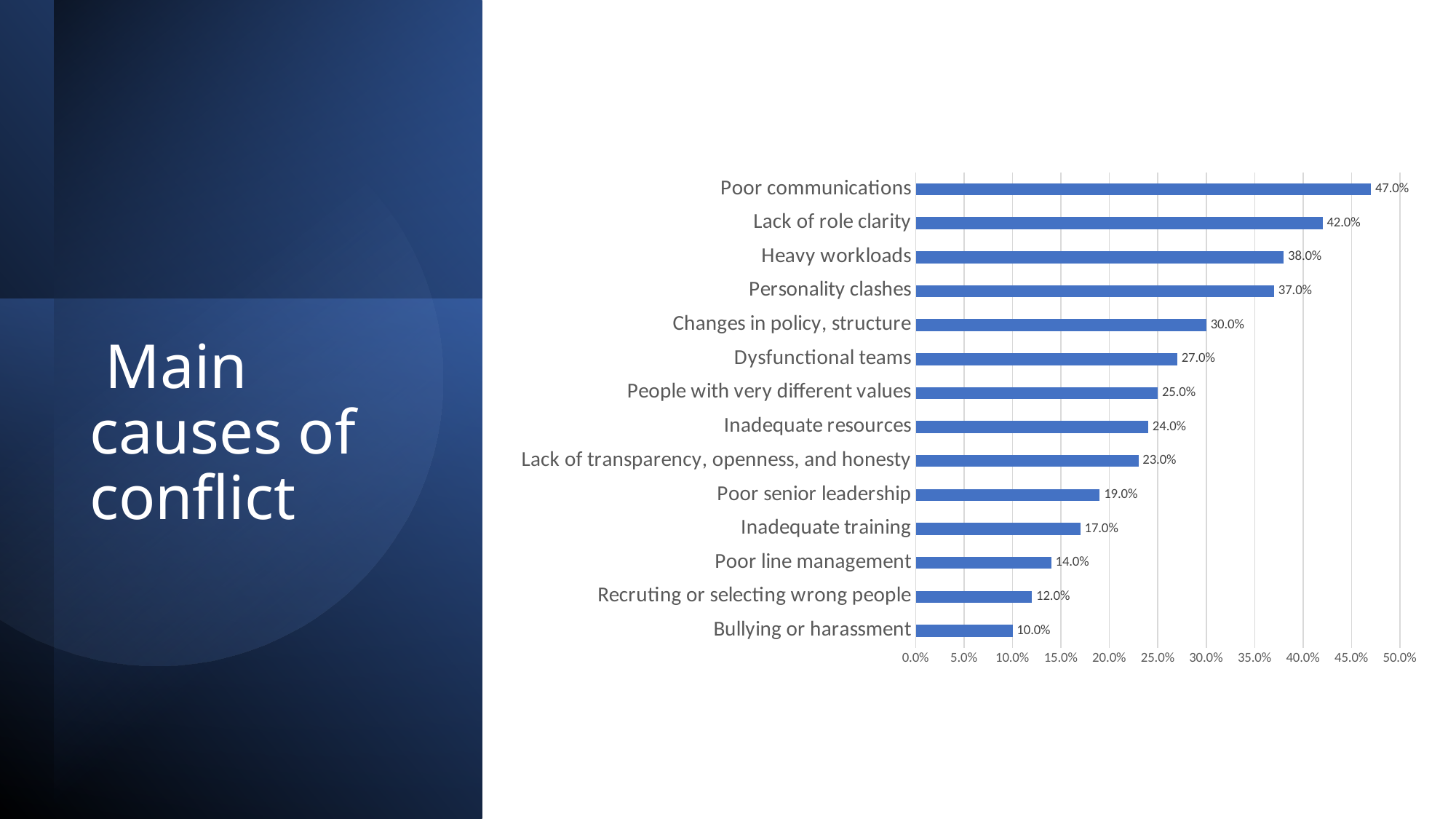
Which category has the highest value? Poor communications What is the difference between the values for Poor senior leadership and Poor line management? 5.0% What is the value for Poor communications? 47.0% What is the title of the slide? Main causes of conflict What kind of chart is shown on the slide? Bar chart Which is larger, the value for Dysfunctional teams or the value for Inadequate training? Dysfunctional teams What is the value for Recruting or selecting wrong people? 12.0% What is the value for Inadequate resources? 24.0% Is the value for Changes in policy, structure greater or less than 25.0%? greater Which category has the lowest value? Bullying or harassment What is the difference between the values for Lack of role clarity and Heavy workloads? 4.0% How many categories are shown in the chart? 14